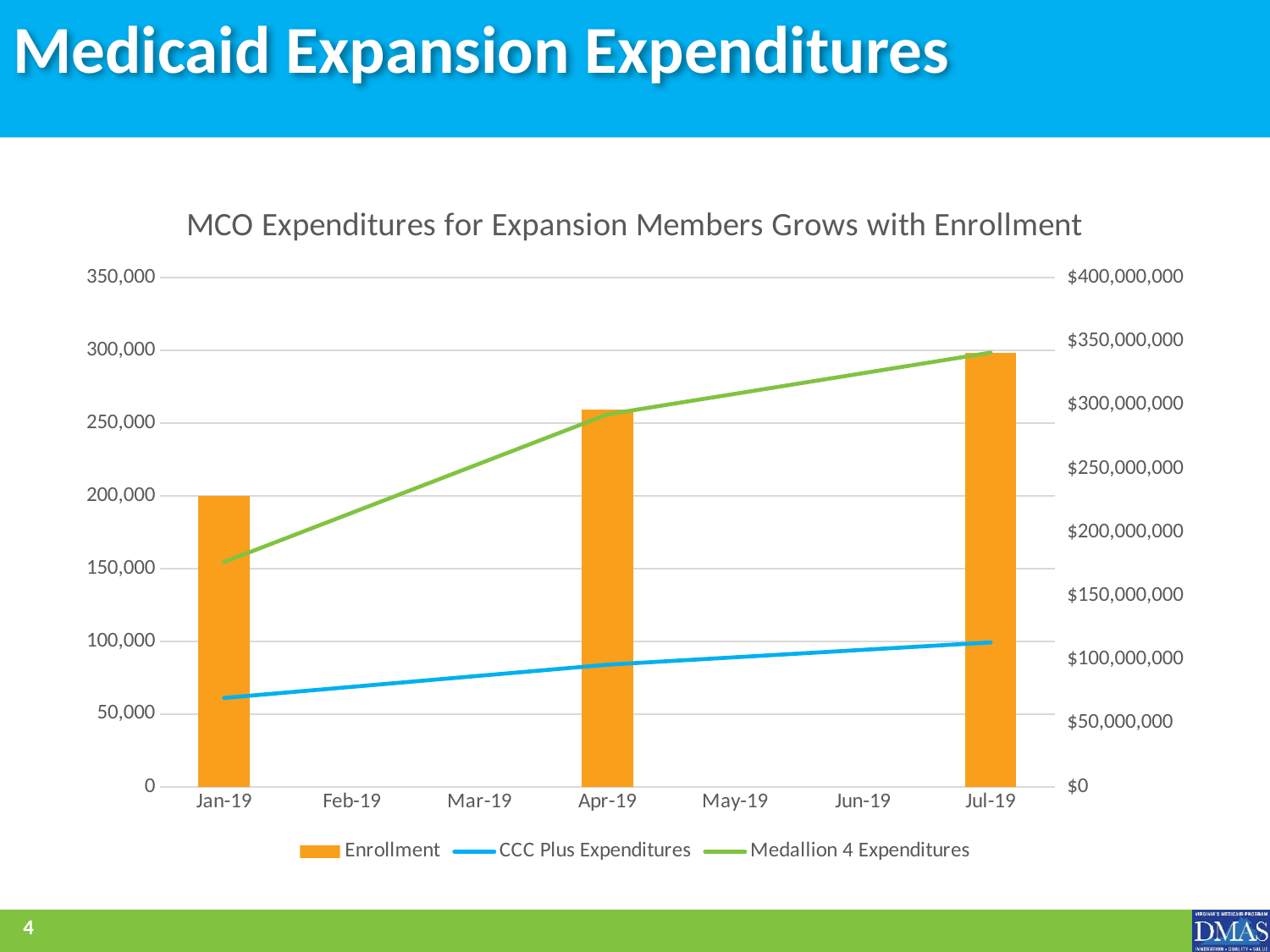
How many months are labelled along the x axis? 7 Is the Medallion 4 Expenditures value for Jan-19 greater or less than $200,000,000? less Which month has the highest Enrollment bar? Jul-19 What is the title of the chart? MCO Expenditures for Expansion Members Grows with Enrollment In Jul-19, which is larger: Medallion 4 Expenditures or CCC Plus Expenditures? Medallion 4 Expenditures How many series does the chart legend list? 3 Is the CCC Plus Expenditures value for Jul-19 greater or less than $100,000,000? greater Is the Enrollment value for Apr-19 greater or less than 250,000? greater Which month has the lowest Enrollment bar? Jan-19 What colour are the Enrollment bars? Orange What kind of chart is shown on the slide? A combination bar and line chart Do the Medallion 4 Expenditures rise or fall from Jan-19 to Jul-19? Rise